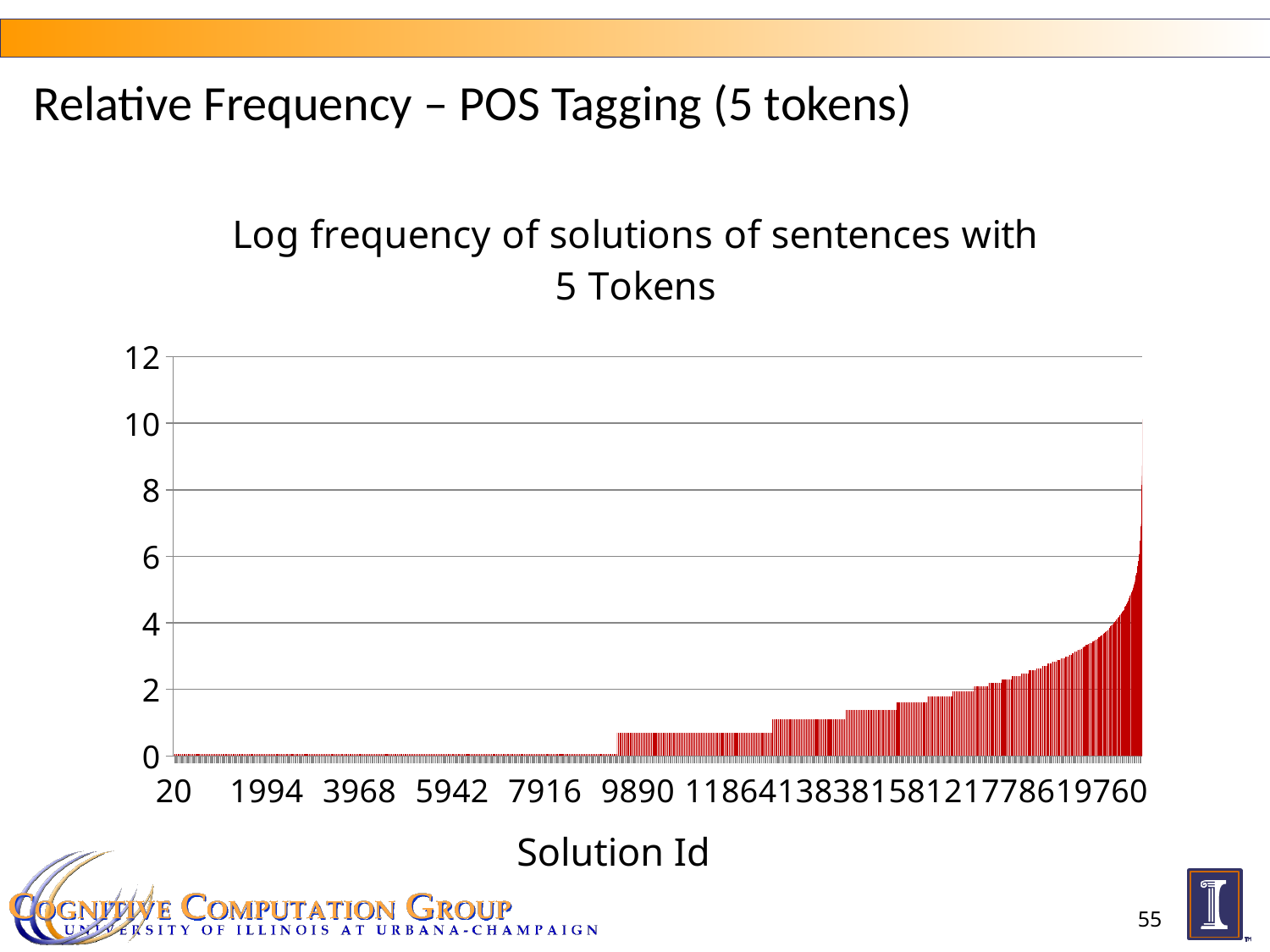
Which end of the x axis has the highest bars, the left (near Solution Id 20) or the right (near Solution Id 19760)? right Is the value for Solution Id 20 greater or less than 2? less Do the bar values rise or fall as Solution Id increases along the x axis? rise What kind of chart is shown on the slide? bar chart What is the highest value shown on the y axis? 12 What is the title of the chart? Log frequency of solutions of sentences with 5 Tokens Is the value for Solution Id 9890 greater or less than 2? less Is the tallest bar in the chart greater or less than 6? greater What is the label of the x axis? Solution Id Which is larger, the value for Solution Id 20 or the value for Solution Id 13838? Solution Id 13838